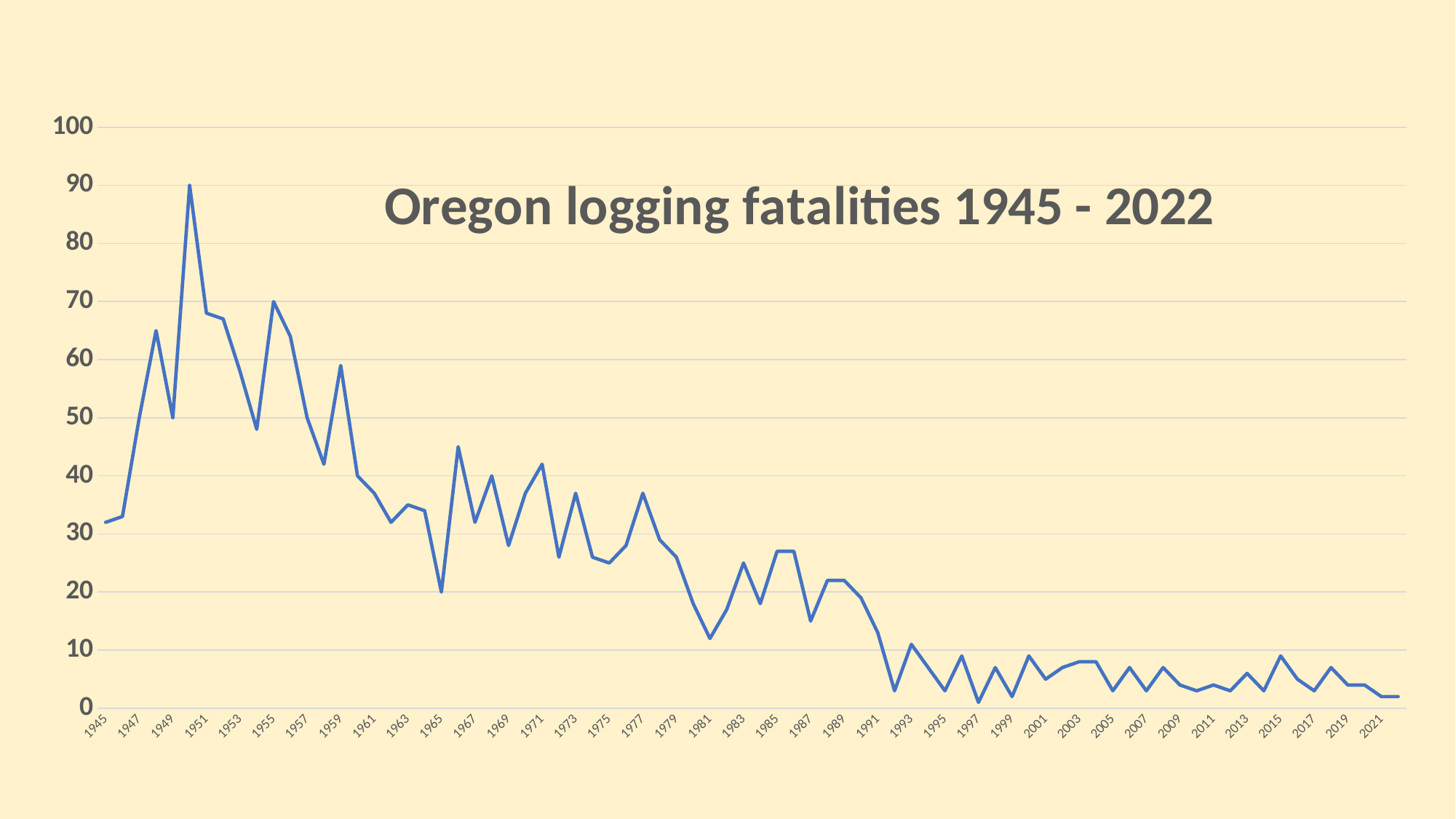
Is the value for 1992 greater or less than 10? less What is the title of the chart? Oregon logging fatalities 1945 - 2022 Overall, do Oregon logging fatalities rise or fall from 1945 to 2022? fall Is the value for 1947 greater or less than 60? less What was the number of Oregon logging fatalities in 1950? 90 In which year were Oregon logging fatalities highest? 1950 What was the number of Oregon logging fatalities in 1955? 70 Is the value for 1981 greater or less than 20? less Which year had more logging fatalities, 1977 or 1981? 1977 What kind of chart is shown on the slide? line chart